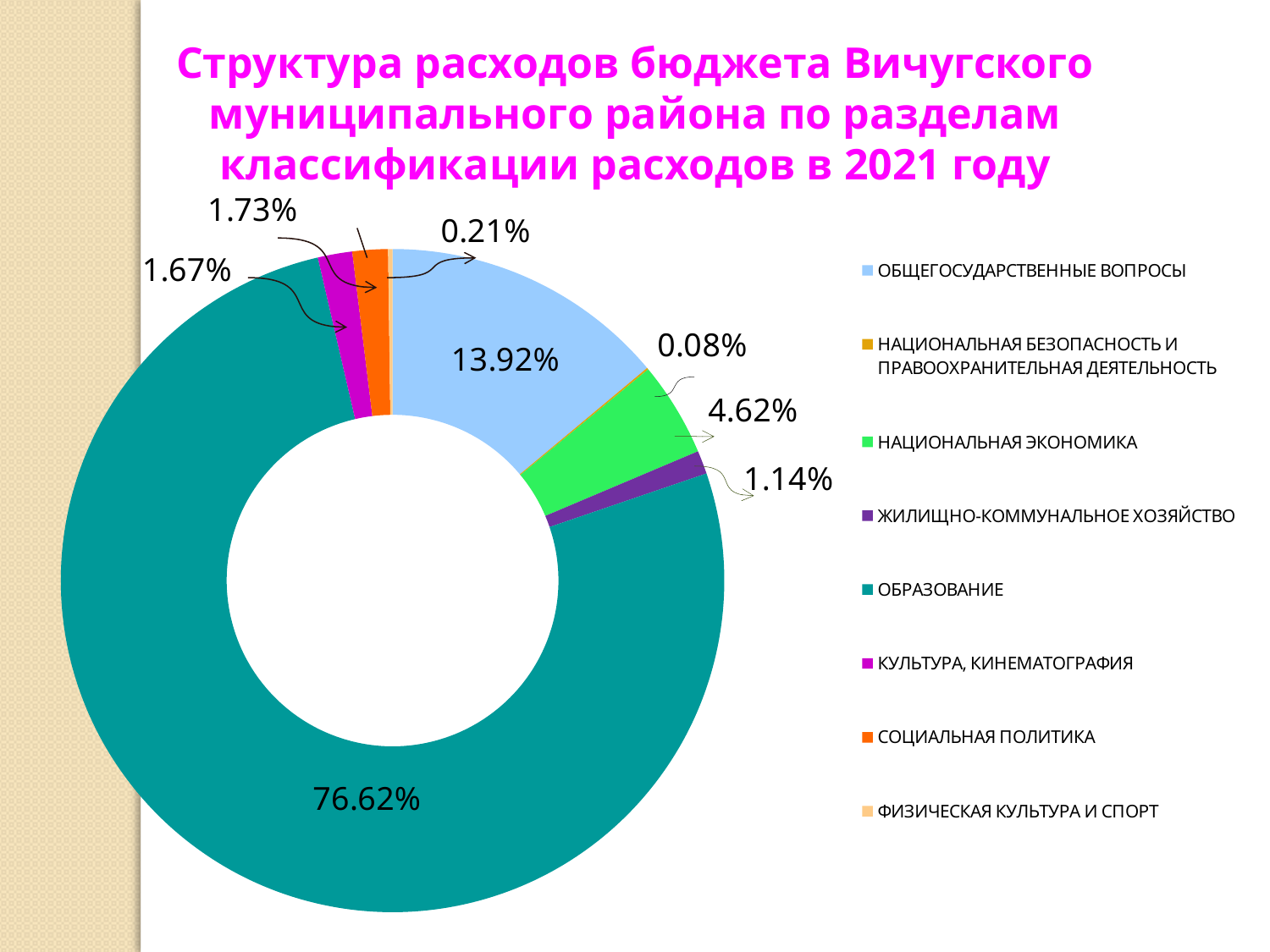
What share of expenditure goes to ОБЩЕГОСУДАРСТВЕННЫЕ ВОПРОСЫ? 13.92% What kind of chart is shown on the slide? Doughnut (pie) chart How many sections does the legend list? 8 What share of expenditure goes to КУЛЬТУРА, КИНЕМАТОГРАФИЯ? 1.67% What share of expenditure goes to ЖИЛИЩНО-КОММУНАЛЬНОЕ ХОЗЯЙСТВО? 1.14% Which is larger, the share of НАЦИОНАЛЬНАЯ ЭКОНОМИКА or the share of ЖИЛИЩНО-КОММУНАЛЬНОЕ ХОЗЯЙСТВО? НАЦИОНАЛЬНАЯ ЭКОНОМИКА What is the difference between the shares of ОБРАЗОВАНИЕ and ОБЩЕГОСУДАРСТВЕННЫЕ ВОПРОСЫ? 62.70% What share of expenditure goes to СОЦИАЛЬНАЯ ПОЛИТИКА? 1.73% What share of expenditure goes to НАЦИОНАЛЬНАЯ ЭКОНОМИКА? 4.62% What share of expenditure goes to ОБРАЗОВАНИЕ? 76.62% Which section has the largest share of expenditure? ОБРАЗОВАНИЕ Which section has the smallest share of expenditure? НАЦИОНАЛЬНАЯ БЕЗОПАСНОСТЬ И ПРАВООХРАНИТЕЛЬНАЯ ДЕЯТЕЛЬНОСТЬ